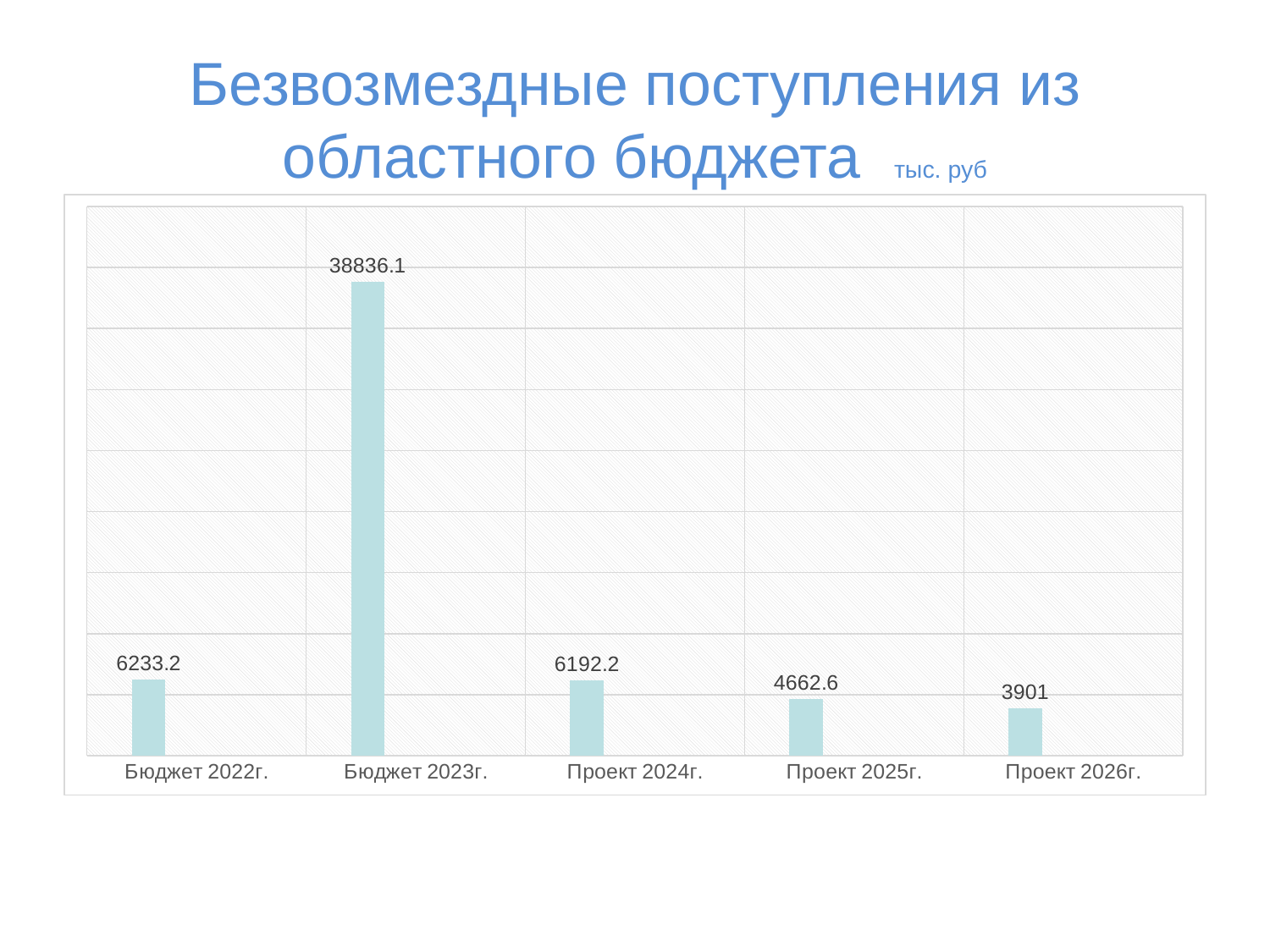
What is the value for Бюджет 2022г.? 6233.2 What is the value for Проект 2025г.? 4662.6 What is the difference between the values for Бюджет 2023г. and Бюджет 2022г.? 32602.9 Which is larger, the value for Проект 2024г. or the value for Проект 2025г.? Проект 2024г. What is the value for Бюджет 2023г.? 38836.1 Do the values rise or fall from Проект 2024г. to Проект 2026г.? fall What is the difference between the values for Проект 2025г. and Проект 2026г.? 761.6 How many categories are shown on the x axis? 5 What is the value for Проект 2026г.? 3901 Which category has the lowest value? Проект 2026г. What kind of chart is shown on the slide? bar chart Which category has the highest value? Бюджет 2023г.